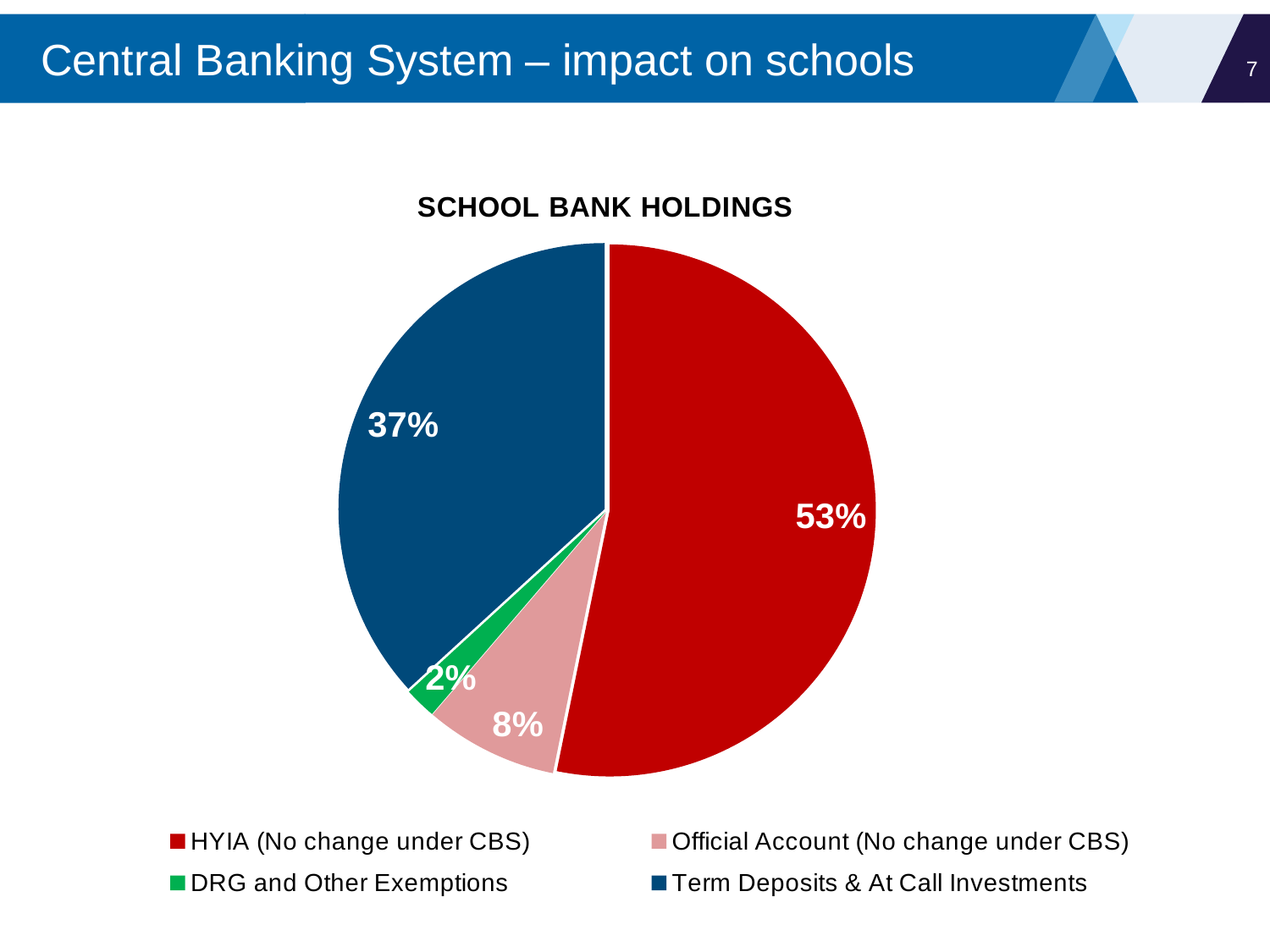
What colour is the slice for Term Deposits & At Call Investments? dark blue Which category has the smallest share of school bank holdings? DRG and Other Exemptions Which is larger: the share for Official Account (No change under CBS) or the share for DRG and Other Exemptions? Official Account (No change under CBS) Which category has the largest share of school bank holdings? HYIA (No change under CBS) What share of school bank holdings is DRG and Other Exemptions? 2% What is the difference in percentage points between HYIA (No change under CBS) and Term Deposits & At Call Investments? 16 percentage points What share of school bank holdings is HYIA (No change under CBS)? 53% How many categories does the pie chart show? 4 What share of school bank holdings is Term Deposits & At Call Investments? 37% What type of chart is shown on the slide? pie chart What is the title of the chart? SCHOOL BANK HOLDINGS